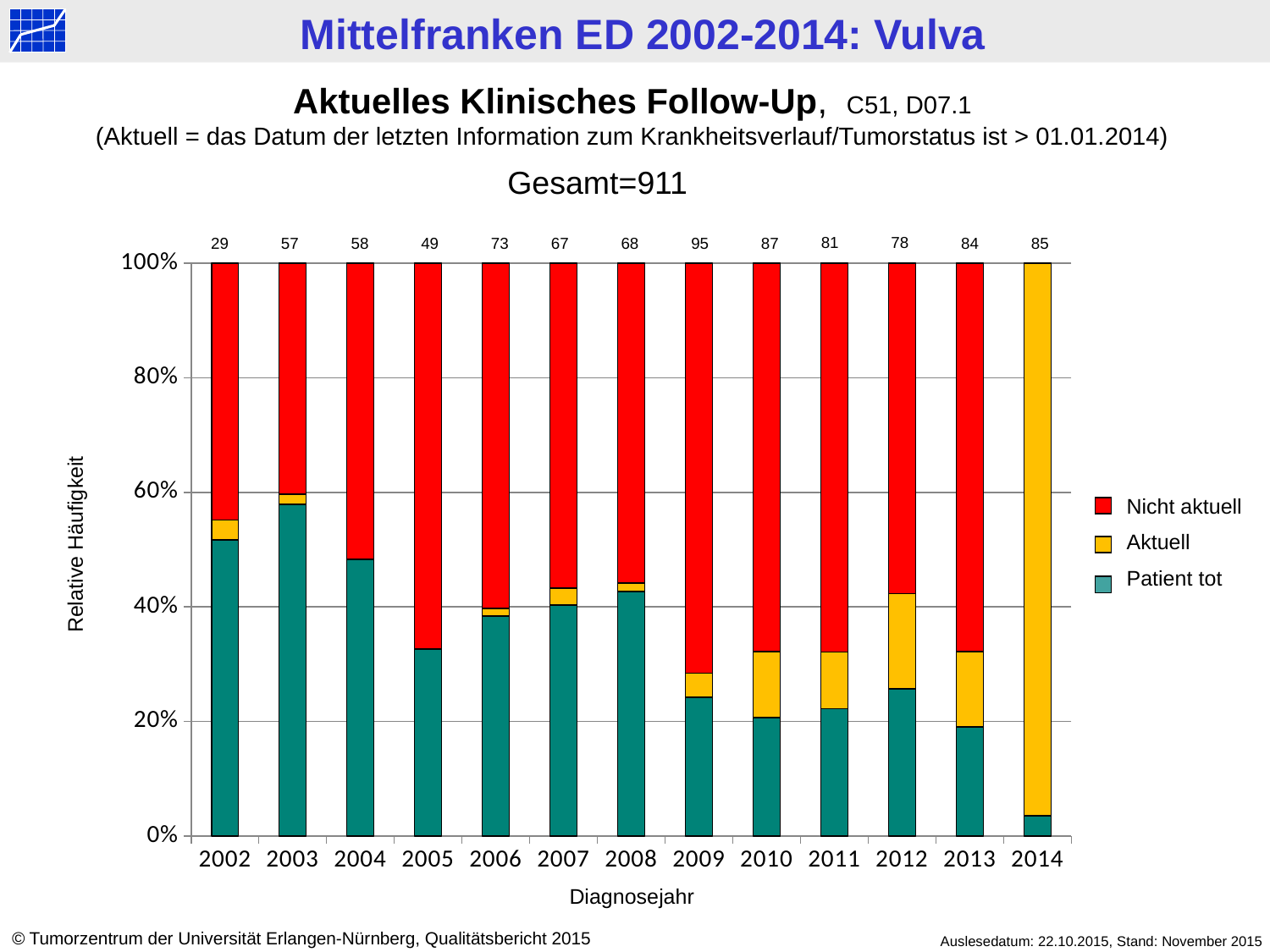
What is the number printed above the bar for 2014? 85 What kind of chart is shown on the slide? stacked bar chart Which diagnosis year has the highest number printed above its bar? 2009 How many series does the legend list? 3 What is the number printed above the bar for 2009? 95 What is the number printed above the bar for 2002? 29 What is the total given as 'Gesamt' on the slide? 911 What is the difference between the numbers printed above the bars for 2009 and 2002? 66 Is the 'Patient tot' share for 2003 greater or less than 40%? greater Which year has the larger number printed above its bar, 2010 or 2011? 2010 How many diagnosis years are shown on the x axis? 13 Which diagnosis year has the lowest number printed above its bar? 2002